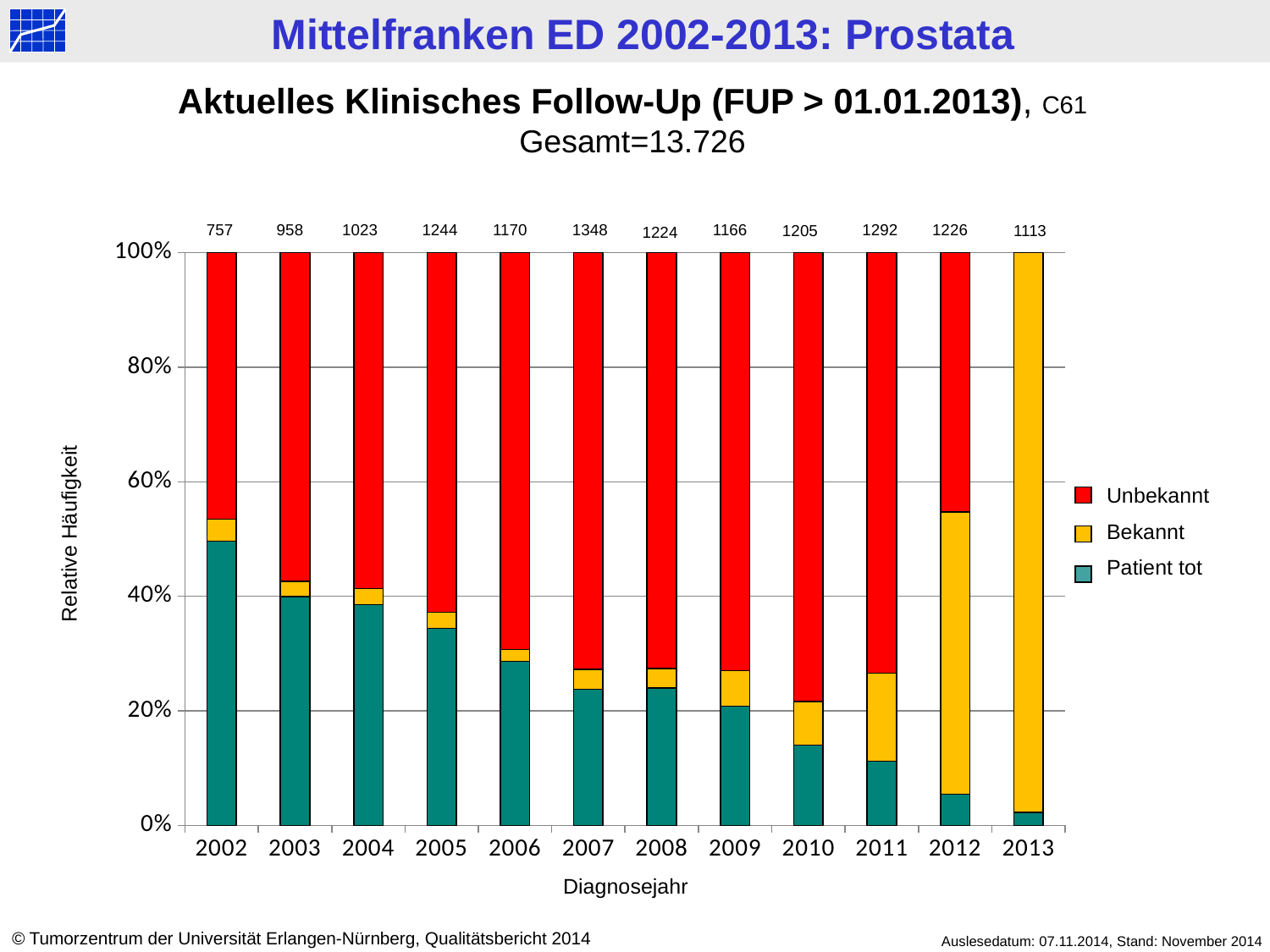
Which diagnosis year has the highest number printed above its bar? 2007 How many diagnosis years are shown on the x axis? 12 Is the 'Patient tot' share for 2002 greater or less than 40%? greater Is the 'Patient tot' share for 2013 greater or less than 20%? less What kind of chart is shown on the slide? Stacked bar chart What number is printed above the bar for 2013? 1113 Which diagnosis year has the lowest number printed above its bar? 2002 How many series does the legend list? 3 What number is printed above the bar for 2007? 1348 What number is printed above the bar for 2002? 757 Which year has the larger number printed above its bar, 2005 or 2011? 2011 What is the difference between the numbers printed above the bars for 2007 and 2002? 591